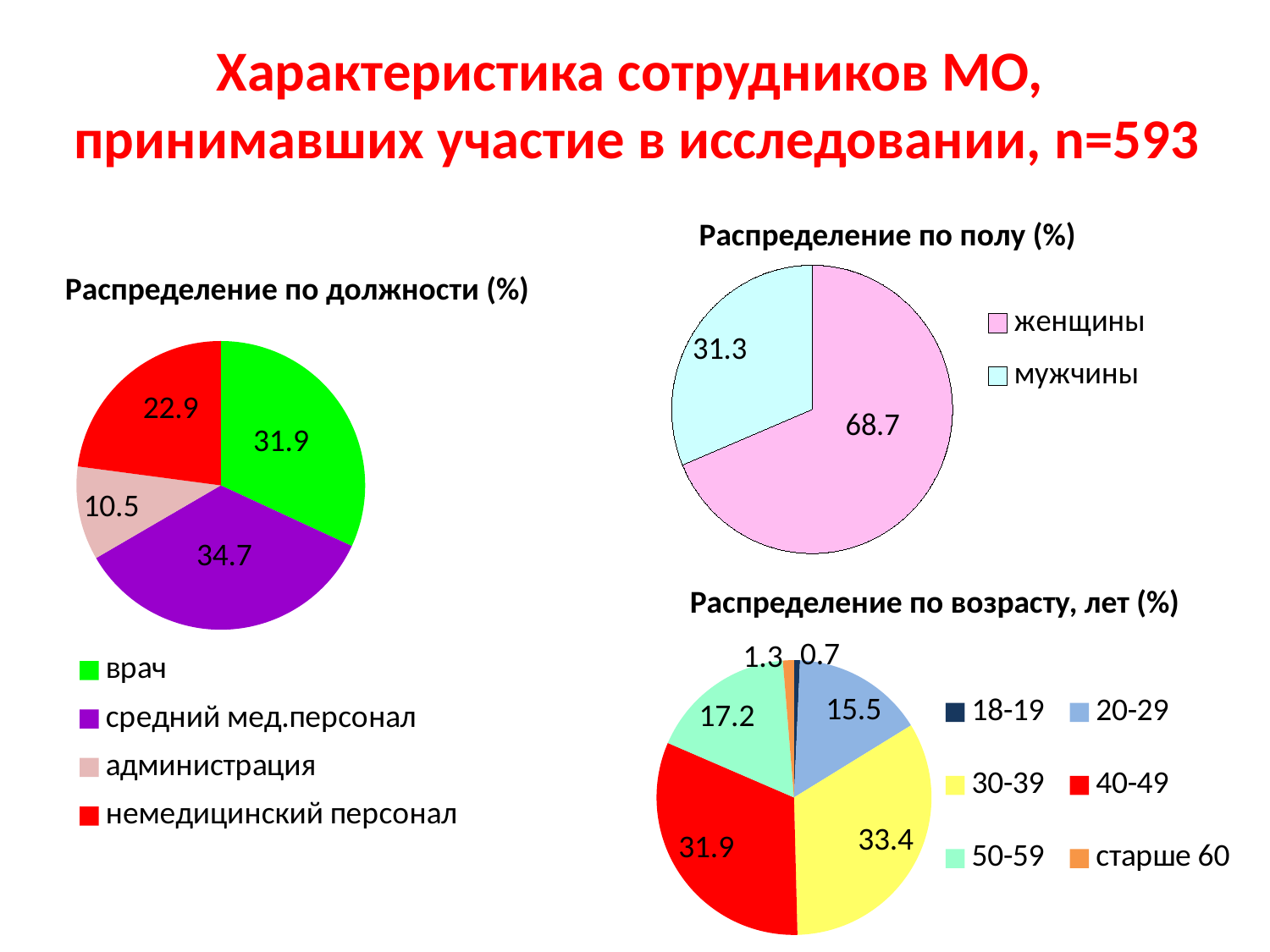
What type of chart is 'Распределение по полу (%)'? pie chart On the chart 'Распределение по должности (%)', which category has the largest share? средний мед.персонал On the chart 'Распределение по возрасту, лет (%)', what is the value for '30-39'? 33.4 On the chart 'Распределение по возрасту, лет (%)', which age group has the smallest share? 18-19 On the chart 'Распределение по должности (%)', what is the value for 'врач'? 31.9 On the chart 'Распределение по возрасту, лет (%)', what is the difference between '40-49' and '20-29'? 16.4 On the chart 'Распределение по должности (%)', which category has the smallest share? администрация On the chart 'Распределение по должности (%)', what is the difference between 'средний мед.персонал' and 'немедицинский персонал'? 11.8 On the chart 'Распределение по возрасту, лет (%)', how many age groups does the legend list? 6 On the chart 'Распределение по полу (%)', which is larger, 'женщины' or 'мужчины'? женщины On the chart 'Распределение по должности (%)', how many categories are shown? 4 On the chart 'Распределение по полу (%)', what is the value for 'мужчины'? 31.3